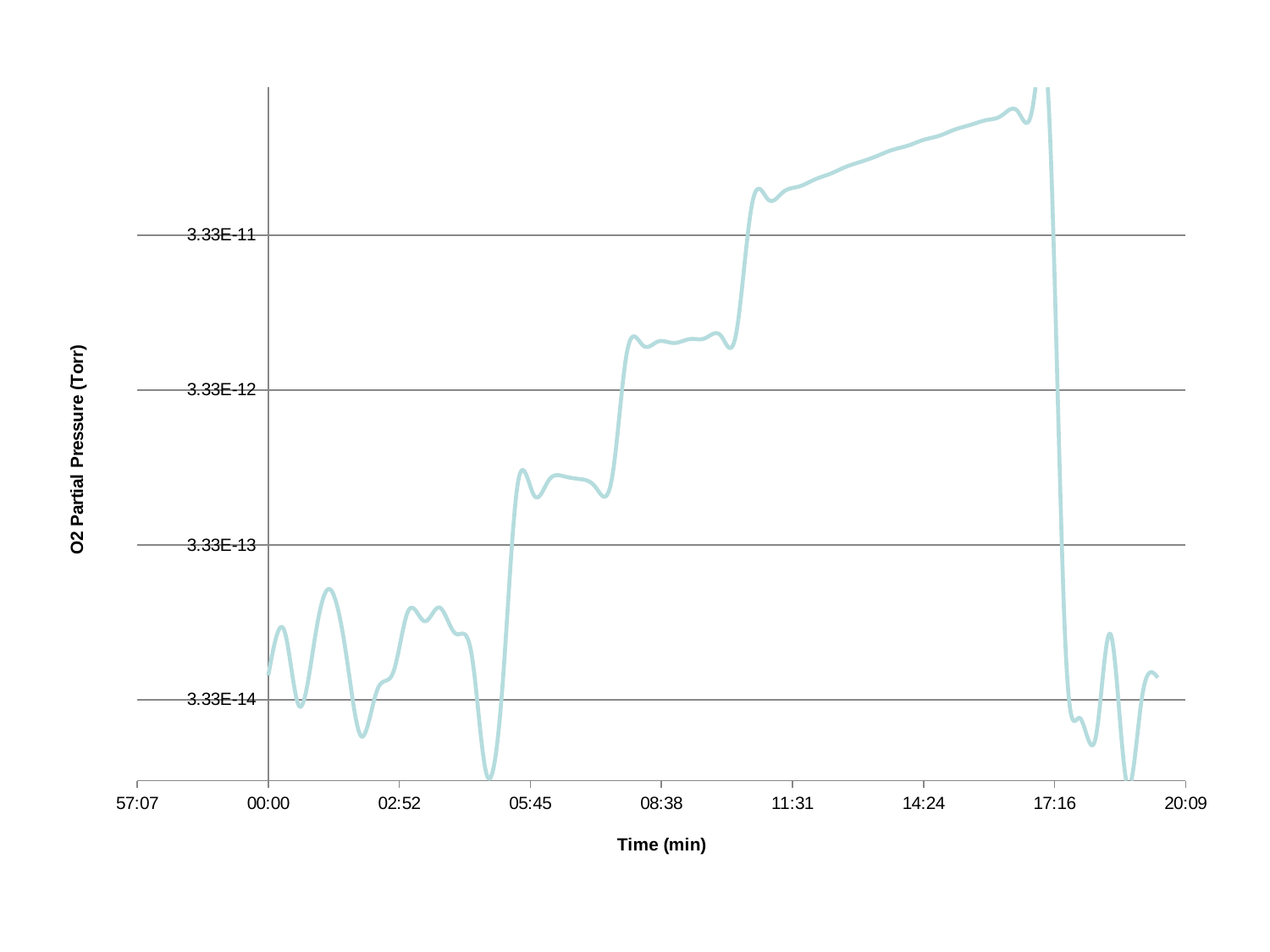
Is the O2 partial pressure at 05:45 greater or less than 3.33E-13? greater What is the title of the x axis? Time (min) Is the O2 partial pressure at 08:38 higher or lower than at 02:52? higher Is the O2 partial pressure at 14:24 higher or lower than at 05:45? higher Is the O2 partial pressure at 00:00 greater or less than 3.33E-13? less What kind of chart is shown on the slide? line chart What is the title of the y axis? O2 Partial Pressure (Torr) Is the O2 partial pressure at 14:24 greater or less than 3.33E-11? greater Does the O2 partial pressure generally rise or fall between 05:45 and 14:24? rise